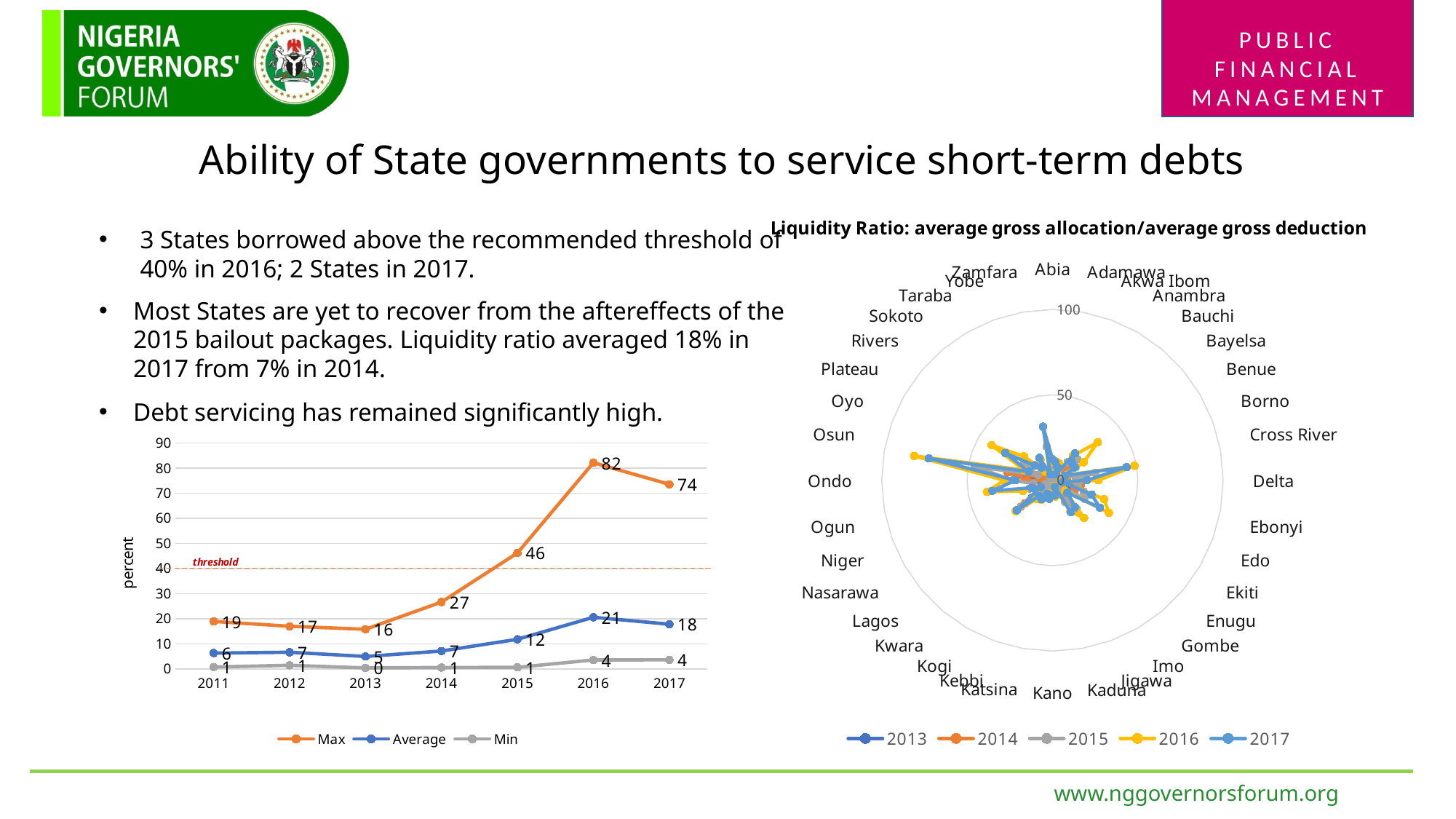
In the line chart on the left, what is the Average value in 2017? 18 In the line chart on the left, is the Max value in 2015 greater or less than 40? greater In the line chart on the left, which year has the lowest Average value? 2013 In the line chart on the left, is the Max value in 2015 greater or less than the Average value in 2016? greater In the line chart on the left, how many series does the legend list? 3 How many series does the legend of the Liquidity Ratio chart on the right list? 5 In the line chart on the left, what is the difference between the Max values in 2016 and 2017? 8 What type of chart is the Liquidity Ratio chart on the right? Radar chart In the line chart on the left, how does the Max series change from 2013 to 2016? It rises In the line chart on the left, what is the Min value in 2013? 0 In the line chart on the left, what is the Max value in 2016? 82 In the line chart on the left, which year has the highest Max value? 2016